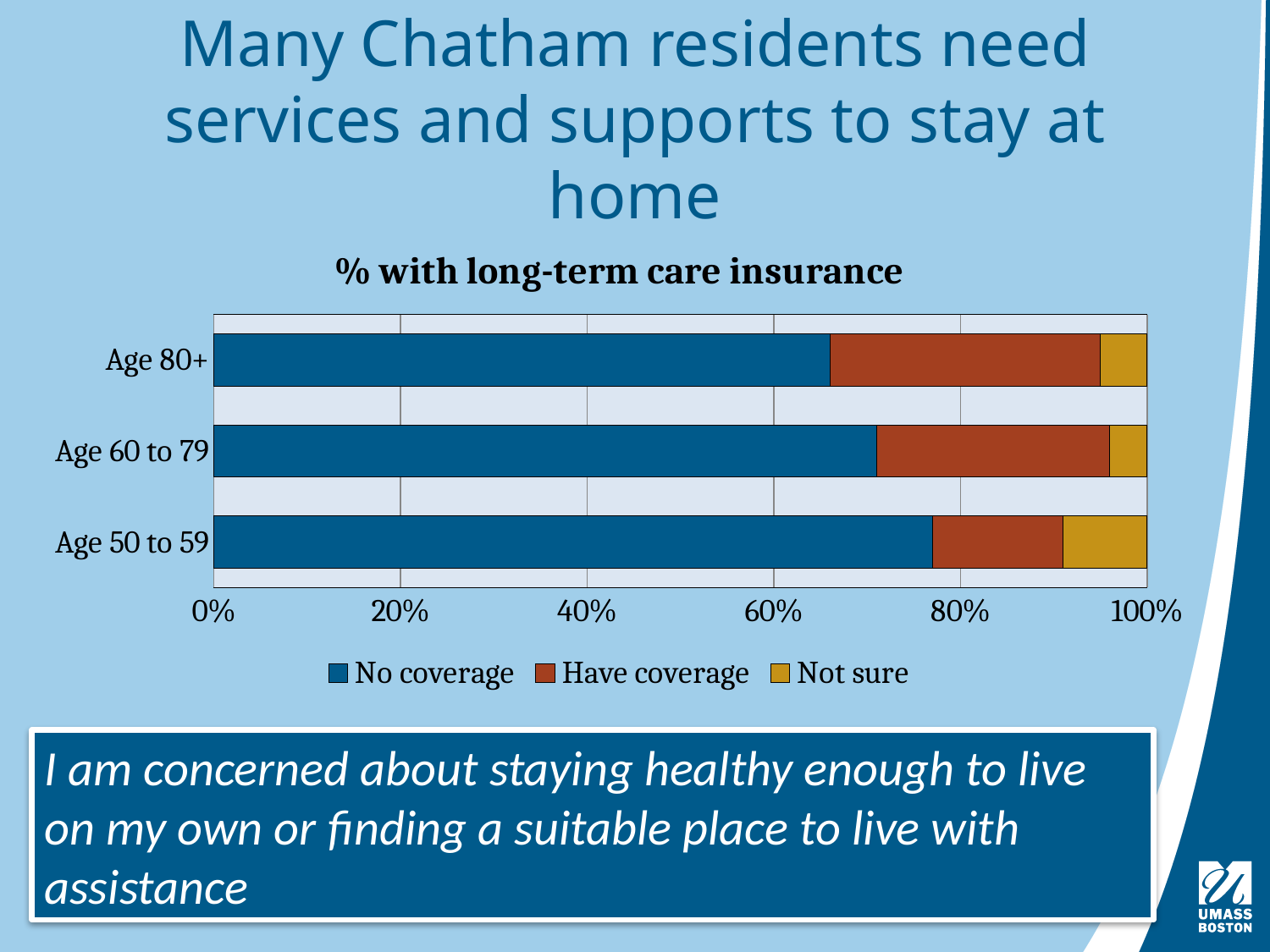
Is the 'No coverage' value for Age 60 to 79 greater or less than 80%? less What are the three series listed in the chart's legend? No coverage, Have coverage, Not sure Is the 'No coverage' value for Age 80+ greater or less than 60%? greater How many age groups are shown in the chart? 3 Which age group has the largest 'No coverage' share? Age 50 to 59 What kind of chart is shown on the slide? Stacked bar chart Which has a larger 'Have coverage' share, Age 80+ or Age 50 to 59? Age 80+ What is the title of the chart? % with long-term care insurance Which age group has the largest 'Not sure' share? Age 50 to 59 Is the 'No coverage' value for Age 50 to 59 greater or less than 80%? less How many series does the chart's legend list? 3 Which age group has the smallest 'No coverage' share? Age 80+